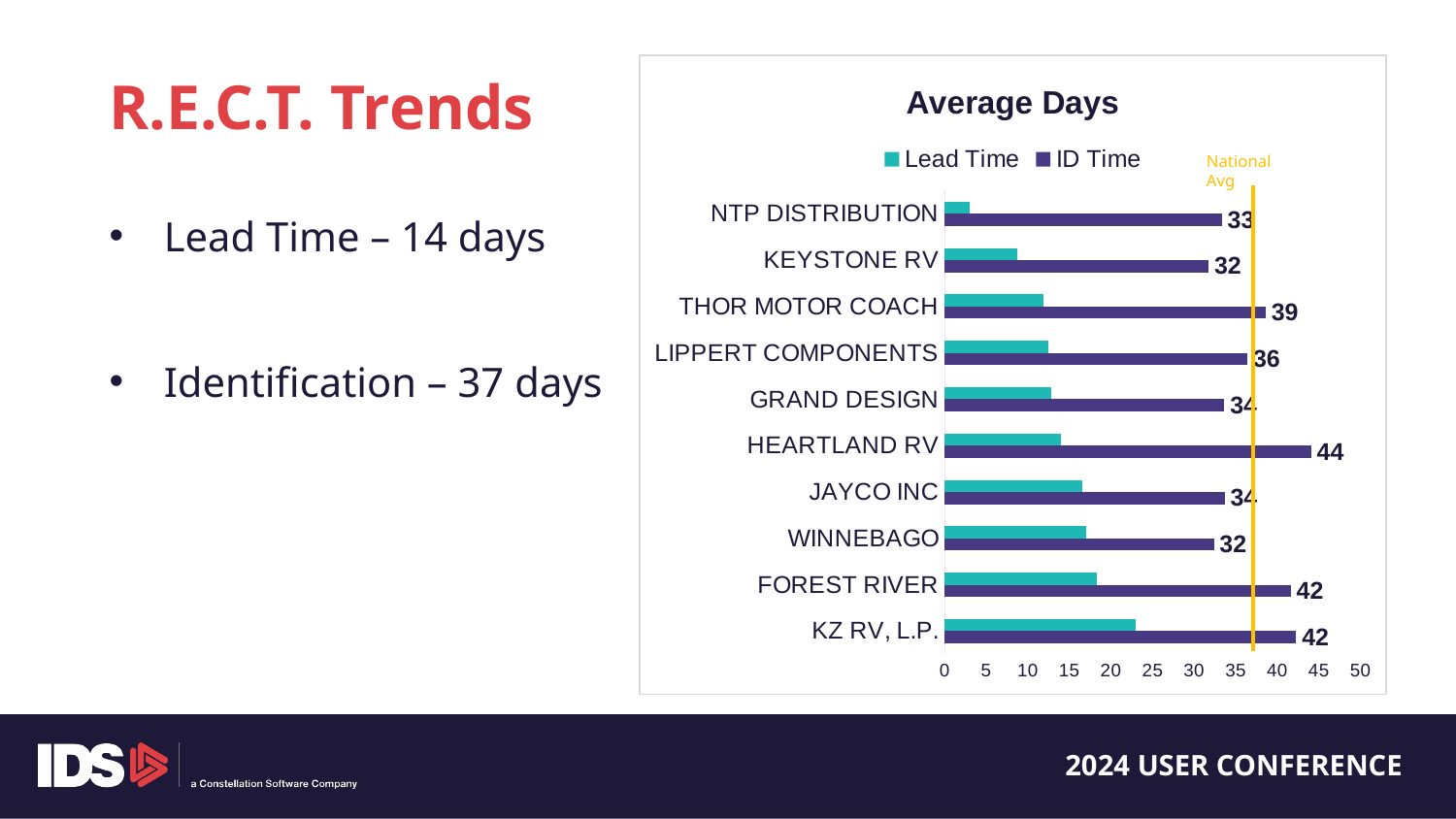
Which has a larger ID Time, THOR MOTOR COACH or LIPPERT COMPONENTS? THOR MOTOR COACH How many categories are shown on the chart? 10 What is the ID Time value for KEYSTONE RV? 32 Which category has the highest ID Time? HEARTLAND RV What is the title of the chart? Average Days Is the Lead Time value for KZ RV, L.P. greater or less than 20? greater Is the Lead Time value for NTP DISTRIBUTION greater or less than 5? less What is the difference between the ID Time for HEARTLAND RV and the ID Time for WINNEBAGO? 12 What is the ID Time value for LIPPERT COMPONENTS? 36 What is the ID Time value for HEARTLAND RV? 44 How many series does the legend list? 2 What kind of chart is shown on the slide? bar chart